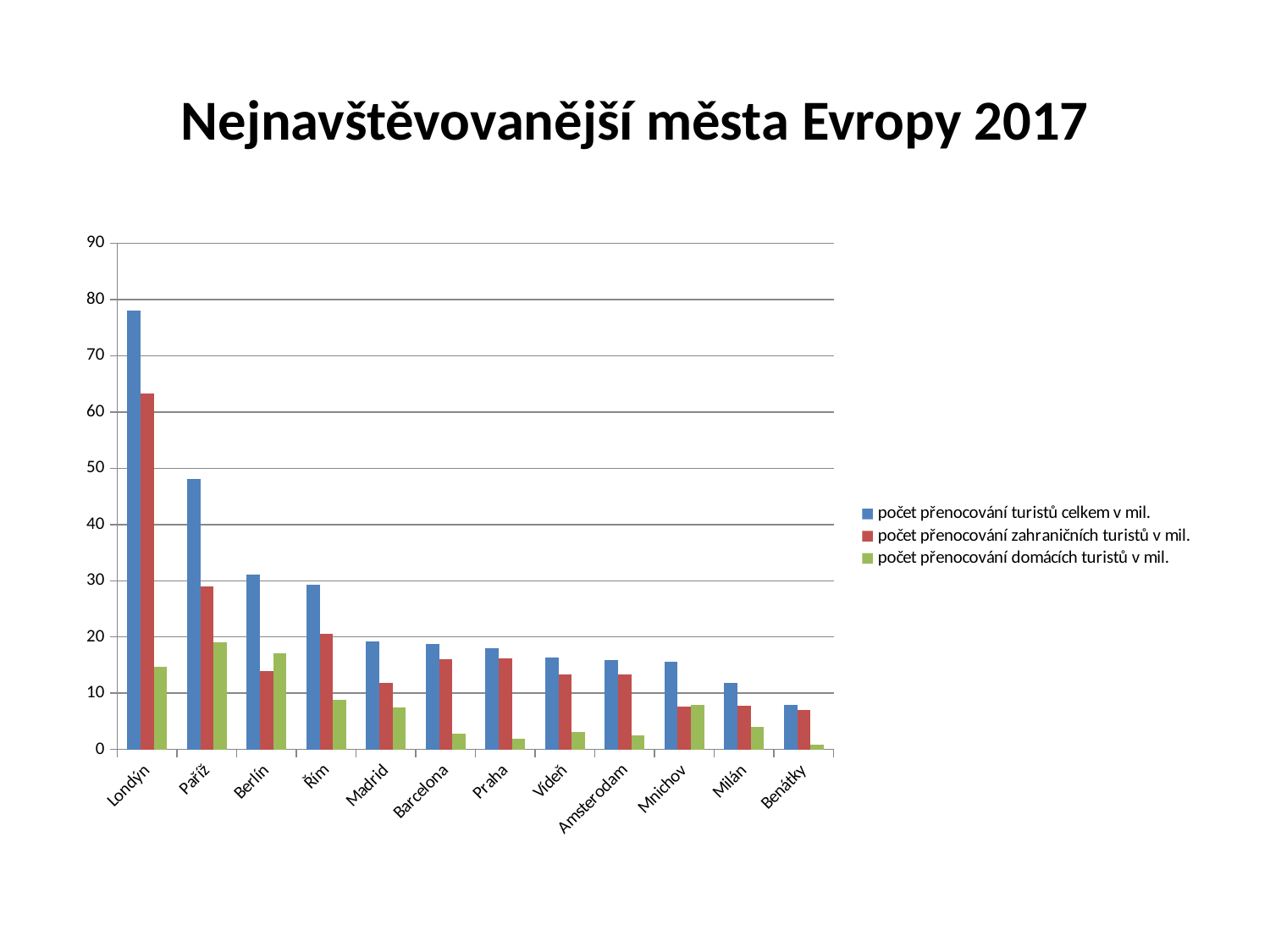
Is the value for Praha in 'počet přenocování domácích turistů v mil.' greater or less than 10? less Is the value for Paříž in 'počet přenocování turistů celkem v mil.' greater or less than 50? less Which city has the lowest value for 'počet přenocování turistů celkem v mil.'? Benátky How many series does the legend list? 3 Which city has the lowest value for 'počet přenocování domácích turistů v mil.'? Benátky Which city has the highest value for 'počet přenocování turistů celkem v mil.'? Londýn Which is larger: the 'počet přenocování domácích turistů v mil.' value for Paříž or for Řím? Paříž How many cities are shown on the x axis of the chart? 12 What kind of chart is shown on the slide? bar chart Is the value for Londýn in 'počet přenocování turistů celkem v mil.' greater or less than 70? greater Which city has the highest value for 'počet přenocování zahraničních turistů v mil.'? Londýn Do the values for 'počet přenocování turistů celkem v mil.' rise or fall from left to right along the x axis? fall